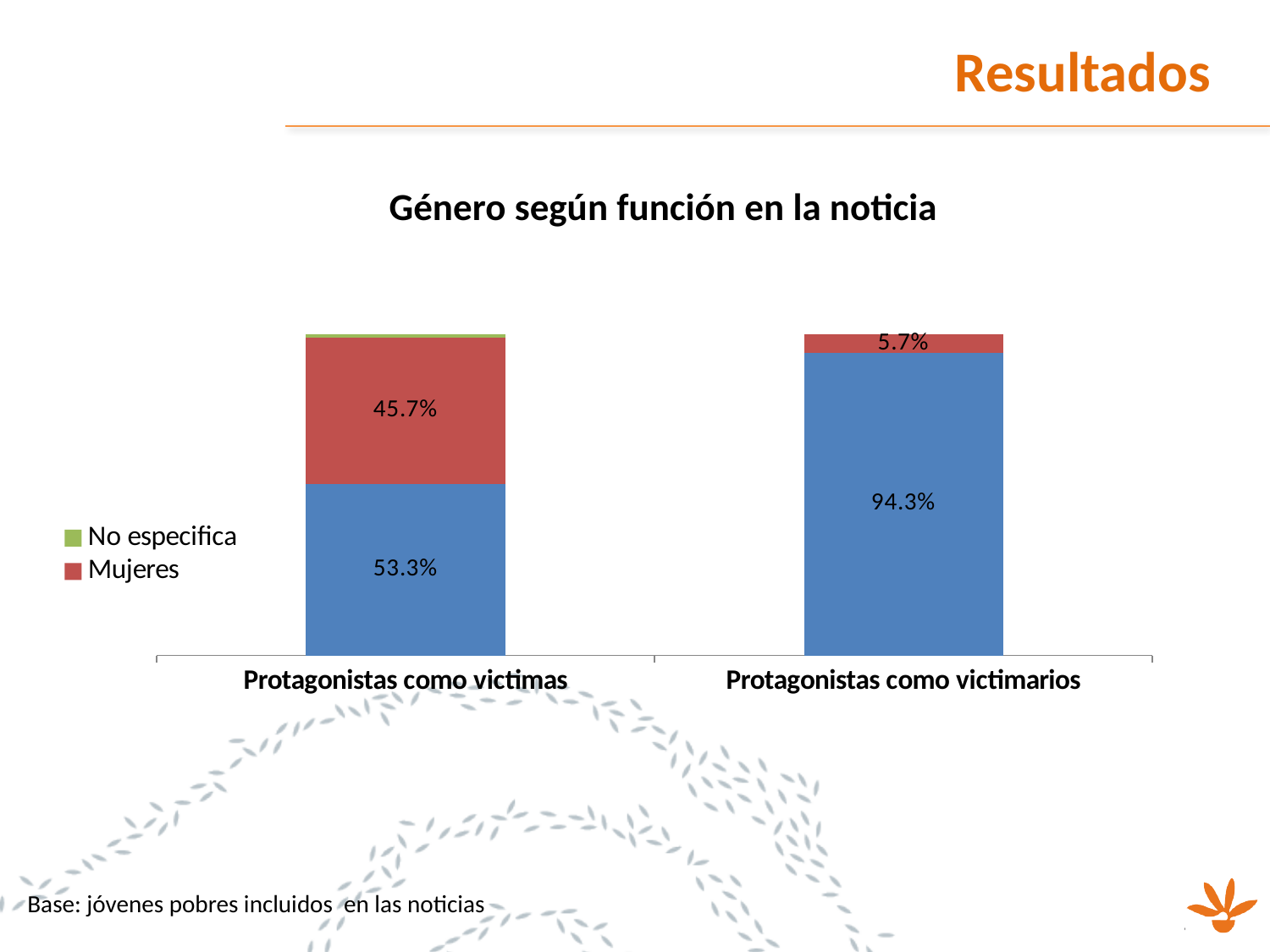
How many categories are shown on the x axis? 2 In which category is the Mujeres value higher? Protagonistas como victimas What is the value for Mujeres in the Protagonistas como victimas bar? 45.7% What is the difference between the Mujeres values for Protagonistas como victimas and Protagonistas como victimarios? 40.0% In the Protagonistas como victimas bar, which is larger: the blue segment or the Mujeres segment? The blue segment How many series does the legend list? 2 What type of chart is shown on the slide? Stacked bar chart What is the title of the chart? Género según función en la noticia What is the value of the blue segment in the Protagonistas como victimas bar? 53.3% What is the total of the labelled segments in the Protagonistas como victimarios bar? 100% What is the value of the blue segment in the Protagonistas como victimarios bar? 94.3% What is the value for Mujeres in the Protagonistas como victimarios bar? 5.7%